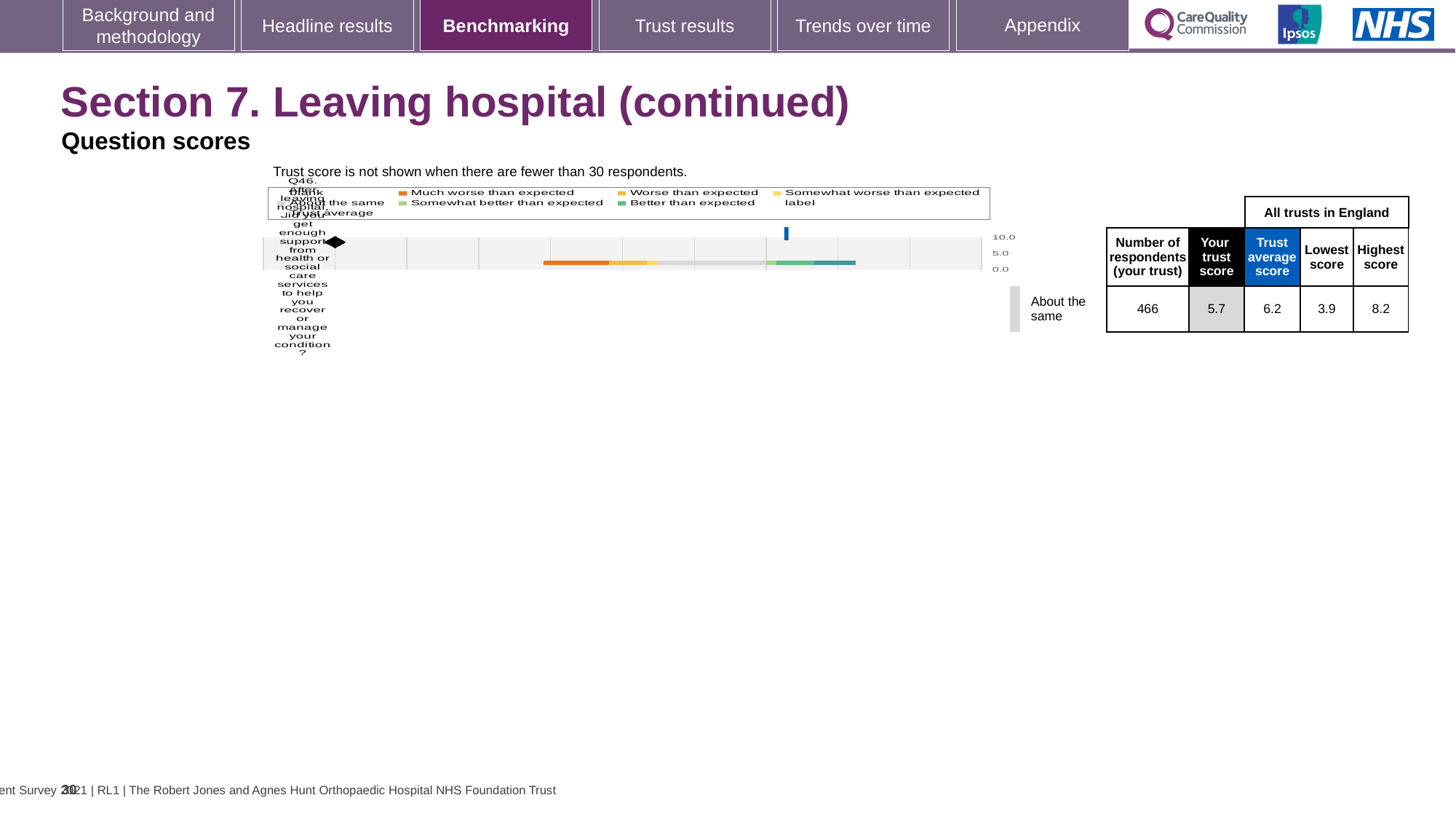
Is the trust's score for Q46 greater or less than 5.0 on the chart axis? greater How many respondents from the trust answered Q46? 466 What is the highest score among all trusts in England for Q46? 8.2 What kind of chart is used to show the Q46 benchmarking result? Bar chart What is the lowest score among all trusts in England for Q46? 3.9 Which is larger for Q46: the trust's own score or the trust average score? Trust average score What is the difference between the highest and lowest scores among all trusts in England for Q46? 4.3 What is the trust average score for Q46 across all trusts in England? 6.2 What is the difference between the trust average score and the trust's own score for Q46? 0.5 How is the trust's result for Q46 categorised relative to other trusts? About the same What is the maximum value shown on the chart's axis? 10.0 What is the trust score for Q46 shown on the slide? 5.7